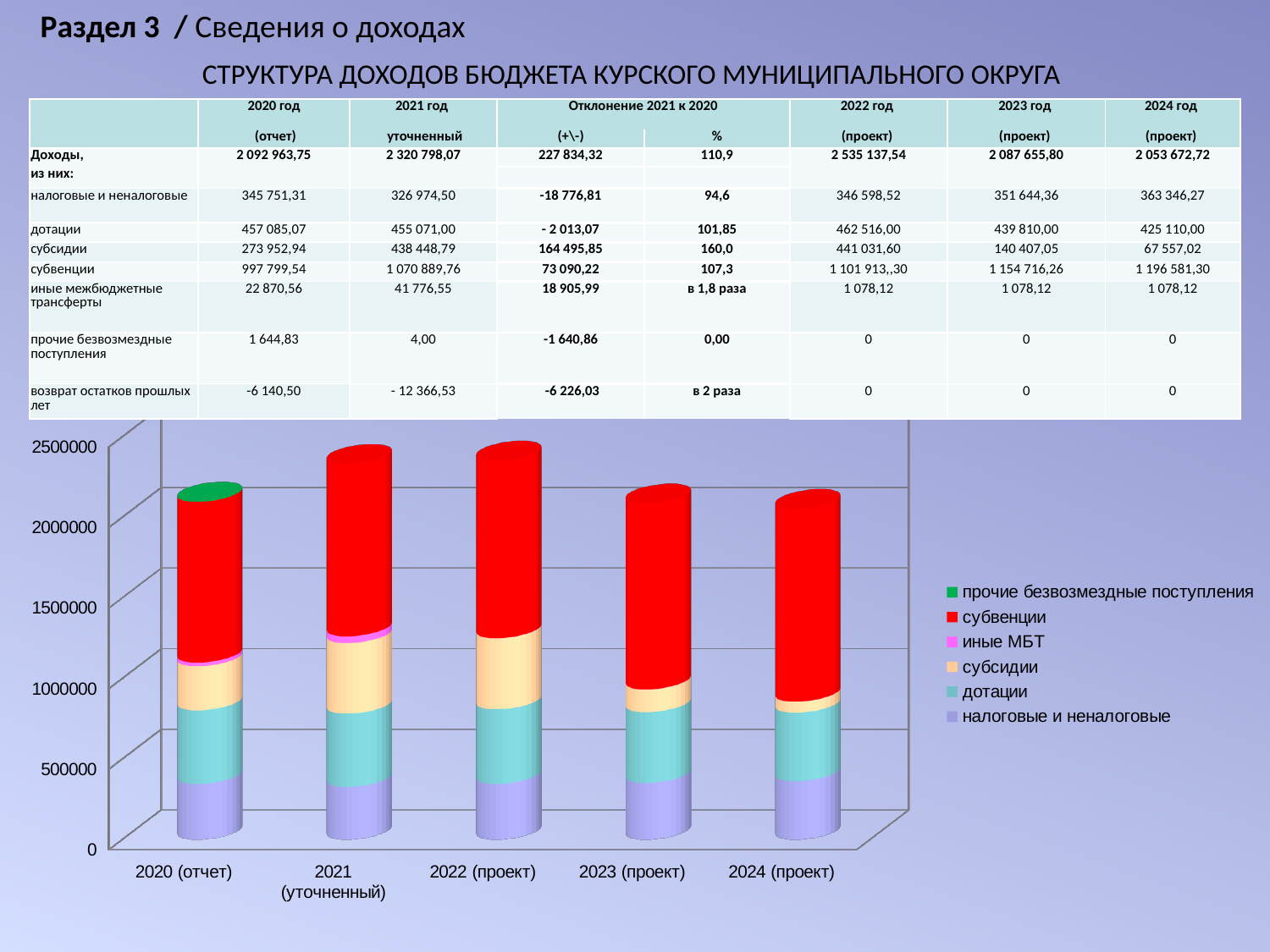
Is the total bar for 2021 (уточненный) greater or less than 2500000? less Do the total bar heights rise or fall from 2020 (отчет) to 2021 (уточненный)? rise Which series is shown in red in the chart legend? субвенции Do the total bar heights rise or fall from 2022 (проект) to 2024 (проект)? fall How many series does the chart legend list? 6 Which series forms the largest segment of every bar in the chart? субвенции Which bar is taller in the chart, 2022 (проект) or 2023 (проект)? 2022 (проект) Is the total bar for 2020 (отчет) greater or less than 2000000? greater How many year categories are shown along the x axis of the chart? 5 What kind of chart is shown at the bottom of the slide? Stacked bar chart Is the total bar for 2024 (проект) greater or less than 1500000? greater Which bar is taller in the chart, 2020 (отчет) or 2021 (уточненный)? 2021 (уточненный)